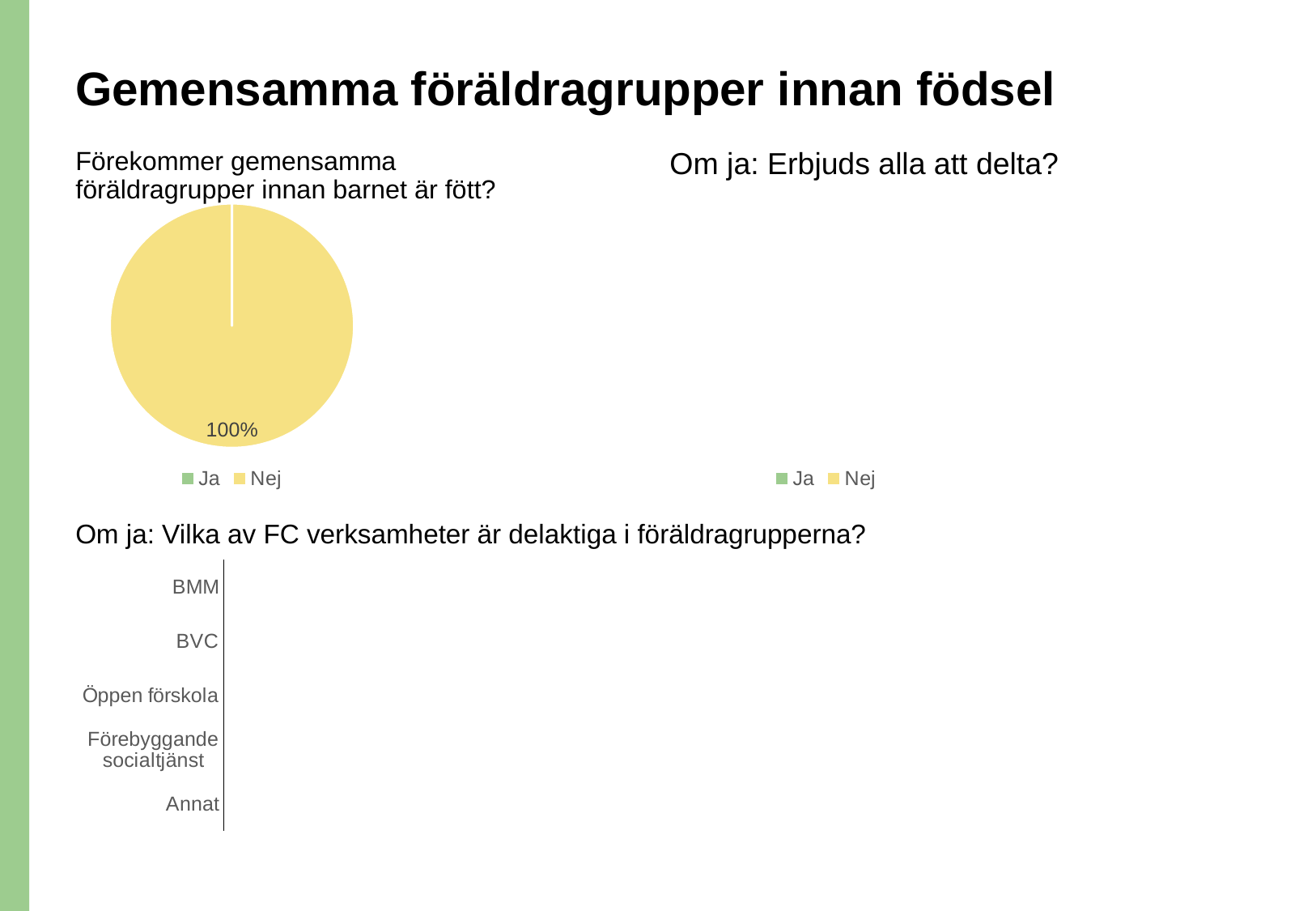
What kind of chart is the one titled "Förekommer gemensamma föräldragrupper innan barnet är fött?"? Pie chart In the chart titled "Förekommer gemensamma föräldragrupper innan barnet är fött?", which is larger, the share for "Ja" or the share for "Nej"? Nej How many categories are listed on the axis of the chart titled "Om ja: Vilka av FC verksamheter är delaktiga i föräldragrupperna?"? 5 In the chart titled "Om ja: Vilka av FC verksamheter är delaktiga i föräldragrupperna?", which category is listed first at the top of the axis? BMM How many entries does the legend list for the chart titled "Förekommer gemensamma föräldragrupper innan barnet är fött?"? 2 In the chart titled "Förekommer gemensamma föräldragrupper innan barnet är fött?", which category makes up the whole pie? Nej In the chart titled "Förekommer gemensamma föräldragrupper innan barnet är fött?", what share of the pie does "Nej" take? 100% How many entries does the legend list for the chart titled "Om ja: Erbjuds alla att delta?"? 2 In the chart titled "Förekommer gemensamma föräldragrupper innan barnet är fött?", what colour represents "Nej" in the legend? Yellow What are the legend entries of the chart titled "Om ja: Erbjuds alla att delta?"? Ja, Nej